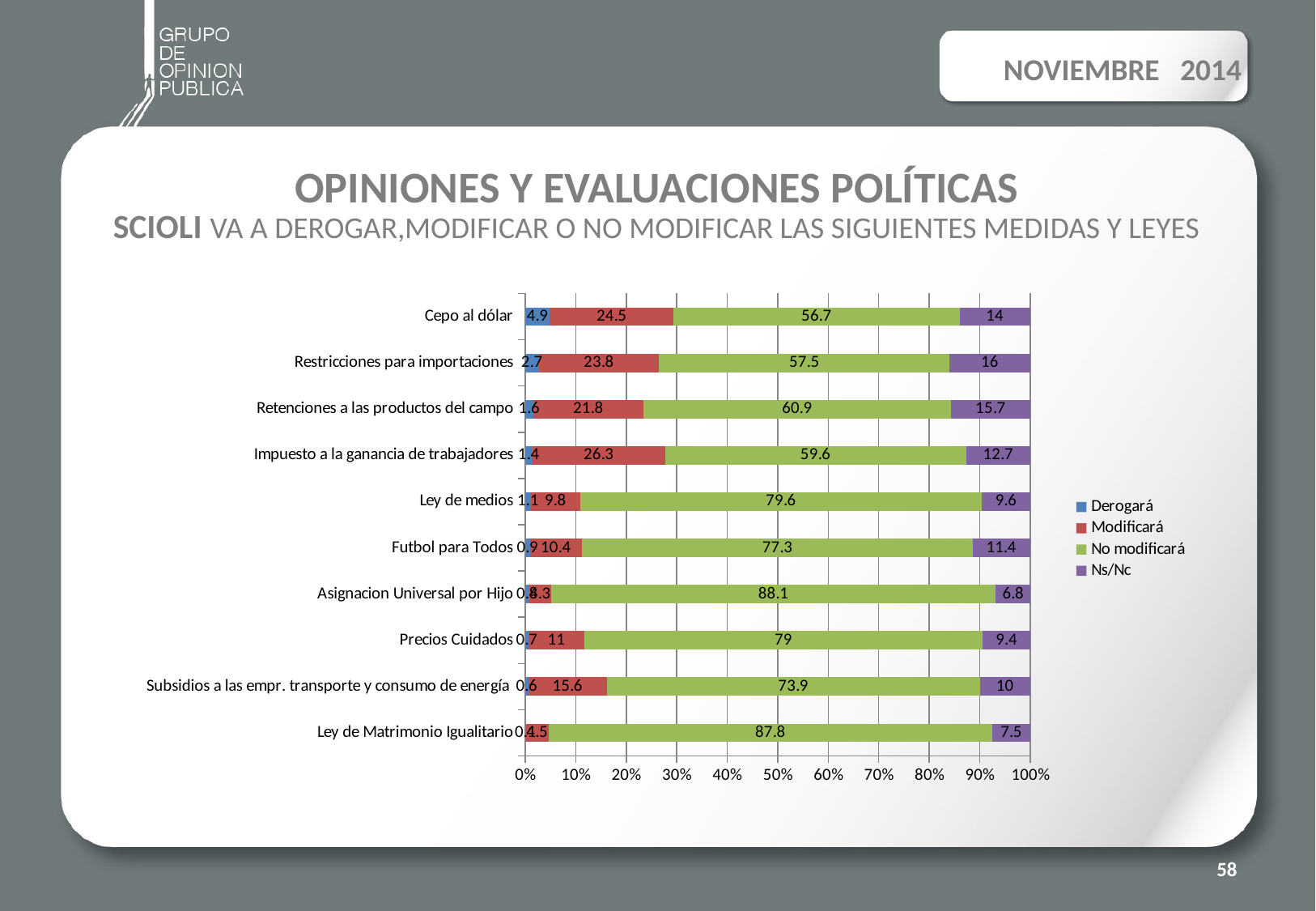
How many measures or laws (categories) are shown in the chart? 10 Which is larger, the 'Modificará' value for Precios Cuidados or for Subsidios a las empr. transporte y consumo de energía? Subsidios a las empr. transporte y consumo de energía How many series does the legend list? 4 Which category has the highest 'No modificará' value? Asignacion Universal por Hijo What kind of chart is shown on the slide? Stacked bar chart What is the 'Ns/Nc' value for Restricciones para importaciones? 16 Which category has the lowest 'No modificará' value? Cepo al dólar What is the 'No modificará' value for Cepo al dólar? 56.7 What is the 'Modificará' value for Impuesto a la ganancia de trabajadores? 26.3 Which legend entry is shown in green? No modificará What is the 'Derogará' value for Cepo al dólar? 4.9 What is the difference between the 'No modificará' values for Ley de medios and Futbol para Todos? 2.3